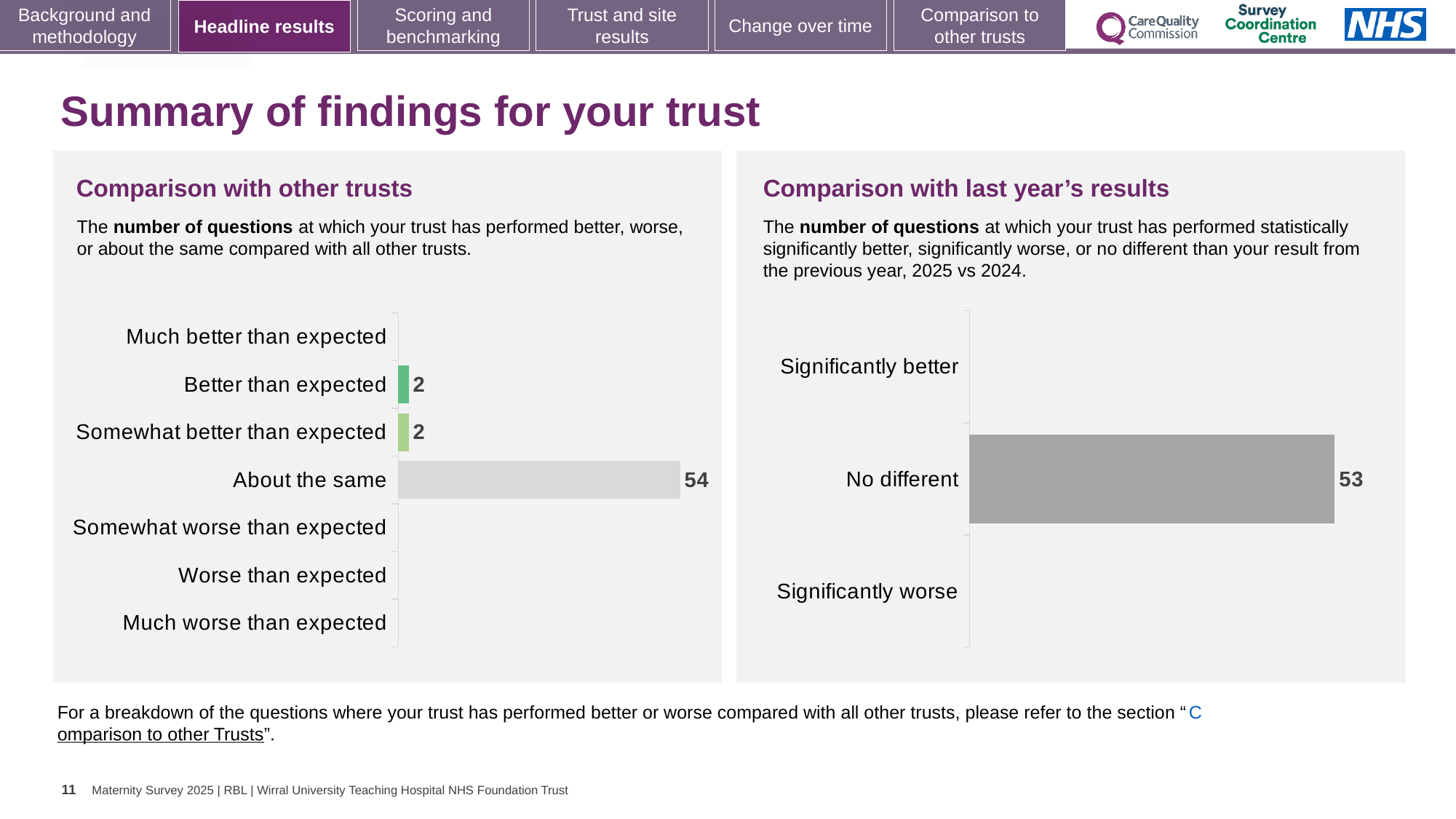
In the 'Comparison with other trusts' chart, what is the difference between the number of questions 'About the same' and the number 'Better than expected'? 52 In the 'Comparison with other trusts' chart, how many questions are 'Better than expected'? 2 In the 'Comparison with other trusts' chart, which category has the highest number of questions? About the same In the 'Comparison with other trusts' chart, how many questions are 'About the same'? 54 What kind of chart is the 'Comparison with last year's results' chart? Bar chart In the 'Comparison with last year's results' chart, which category has the highest number of questions? No different How many categories are listed on the y axis of the 'Comparison with last year's results' chart? 3 In the 'Comparison with other trusts' chart, which is larger: 'About the same' or 'Somewhat better than expected'? About the same How many categories are listed on the y axis of the 'Comparison with other trusts' chart? 7 In the 'Comparison with last year's results' chart, how many questions are 'No different'? 53 What is the title of the chart on the left side of the slide? Comparison with other trusts In the 'Comparison with other trusts' chart, how many questions are 'Somewhat better than expected'? 2